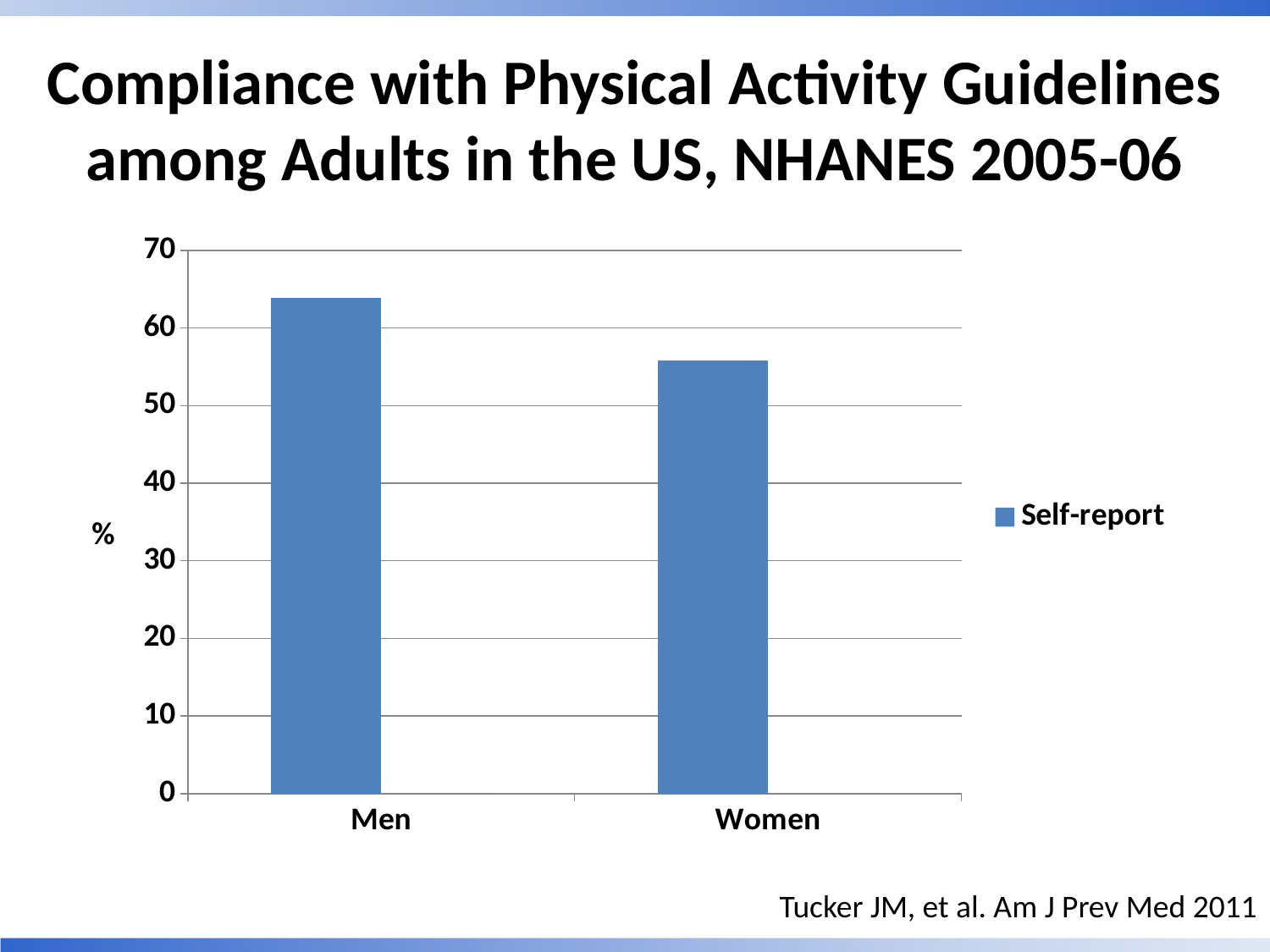
How many categories are shown on the x axis? 2 Is the value for Women greater or less than 60? less Is the value for Women greater or less than 50? greater Which is larger, the value for Men or the value for Women? Men Is the value for Men greater or less than 60? greater Do the values rise or fall from Men to Women along the x axis? fall What is the name of the series listed in the legend? Self-report Which category has the highest self-report value? Men What is the label on the y axis? % Which category has the lowest self-report value? Women What kind of chart is shown on the slide? bar chart How many series does the legend list? 1